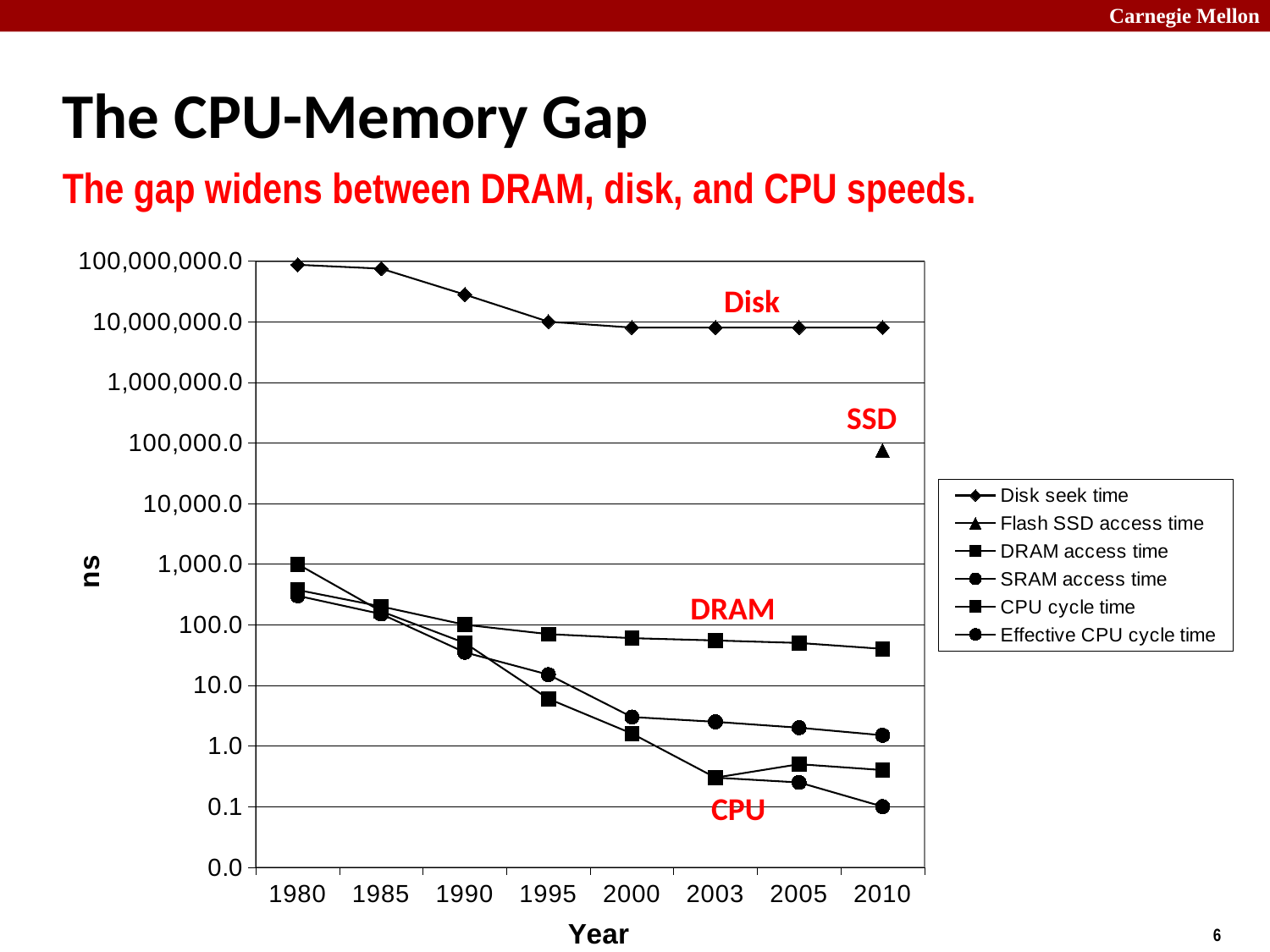
Is the Flash SSD access time in 2010 greater or less than 100,000.0 ns? less Which series has the highest values across all years? Disk seek time Is the DRAM access time in 2010 greater or less than 100.0 ns? less How many series does the legend list? 6 What is the label on the x axis? Year Does the Disk seek time rise or fall from 1980 to 2010? fall What kind of chart is shown on the slide? line chart How many years are marked on the x axis? 8 In 2010, which is larger: Disk seek time or DRAM access time? Disk seek time Is the SRAM access time in 2010 greater or less than 1.0 ns? greater What is the label on the y axis? ns